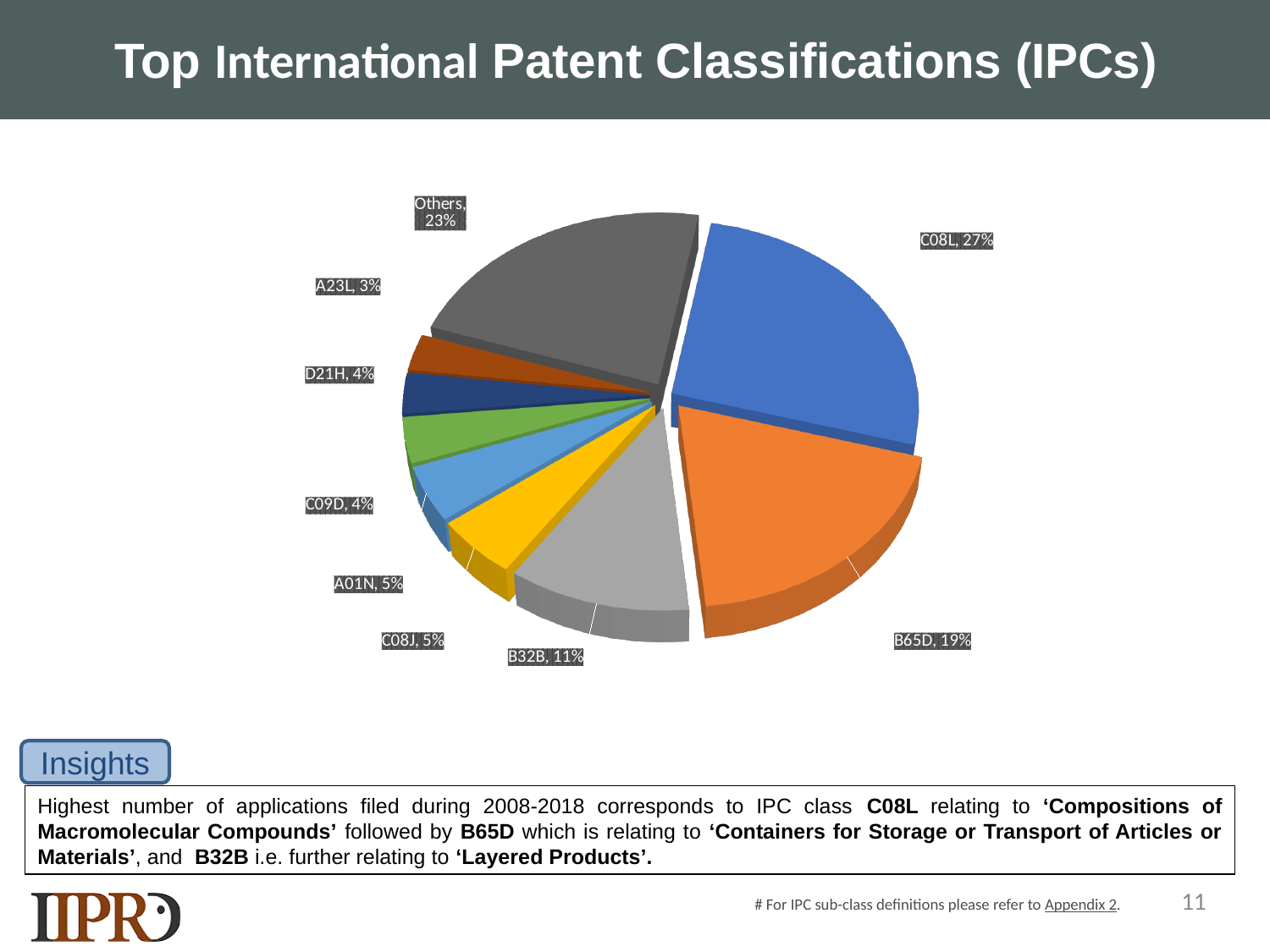
Which is larger, the share for B65D or the share for B32B? B65D What percentage is shown for the 'Others' slice? 23% What type of chart is shown on the slide? Pie chart How many slices does the pie chart have? 9 Which labelled IPC class has the smallest share of the pie? A23L What percentage is shown for D21H? 4% What share of the pie does C08L account for? 27% What is the title of the slide containing the pie chart? Top International Patent Classifications (IPCs) What percentage is shown for B32B? 11% What percentage is shown for B65D? 19% What is the difference in percentage points between the C08L share and the B65D share? 8 Which IPC class has the largest share of the pie? C08L